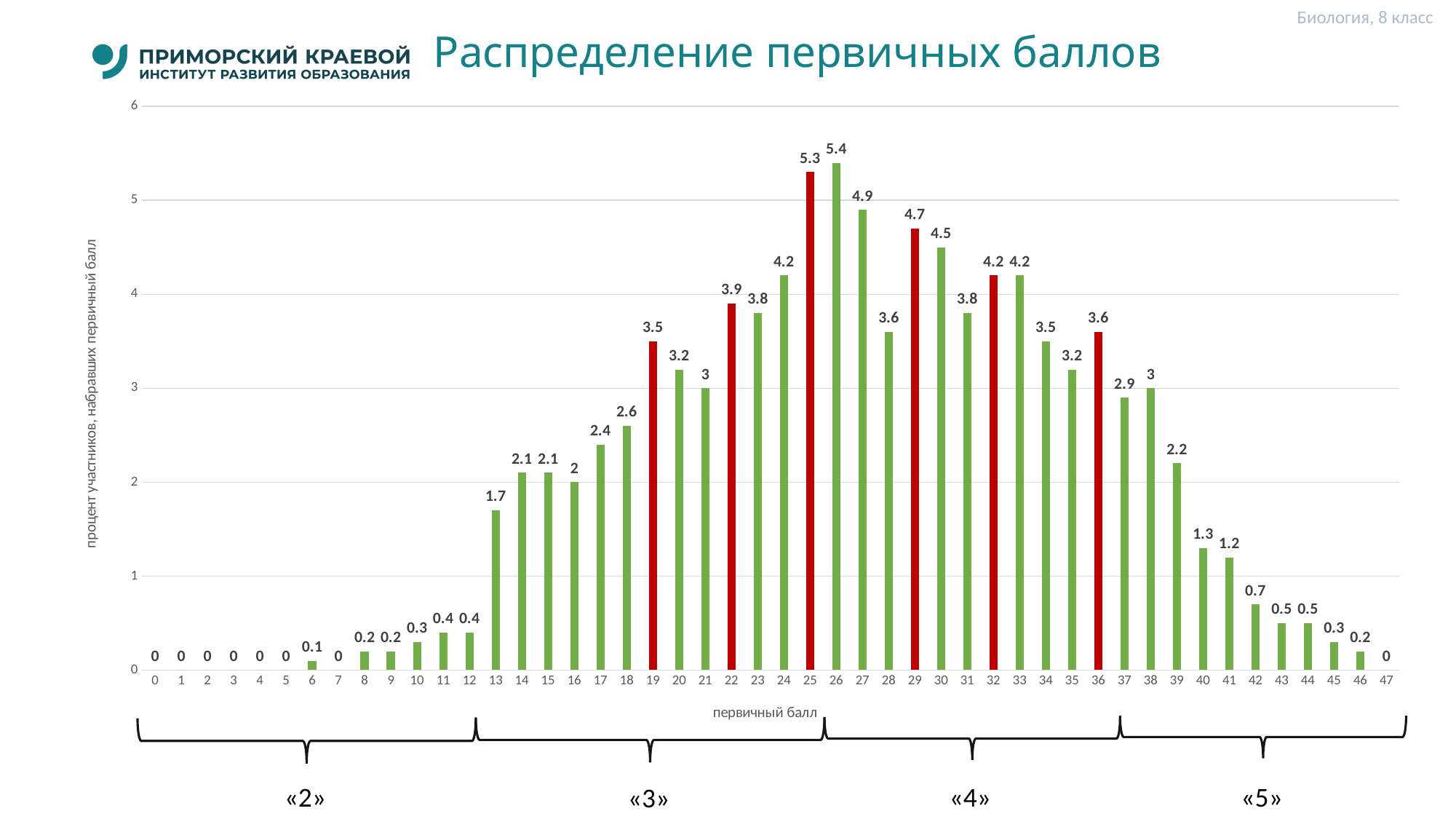
What is the difference between the values for primary scores 26 and 25? 0.1 How many primary score categories are shown on the x axis? 48 Is the value for primary score 24 greater or less than 4? greater Do the values rise or fall along the x axis from primary score 38 to 47? fall What kind of chart is shown on the slide? bar chart What is the difference between the values for primary scores 29 and 28? 1.1 How many bars are coloured red? 6 What is the value for primary score 40? 1.3 What is the value for primary score 26? 5.4 Which is larger, the value for primary score 27 or the value for primary score 30? 27 Which primary score has the highest percentage of participants? 26 What is the value for primary score 13? 1.7